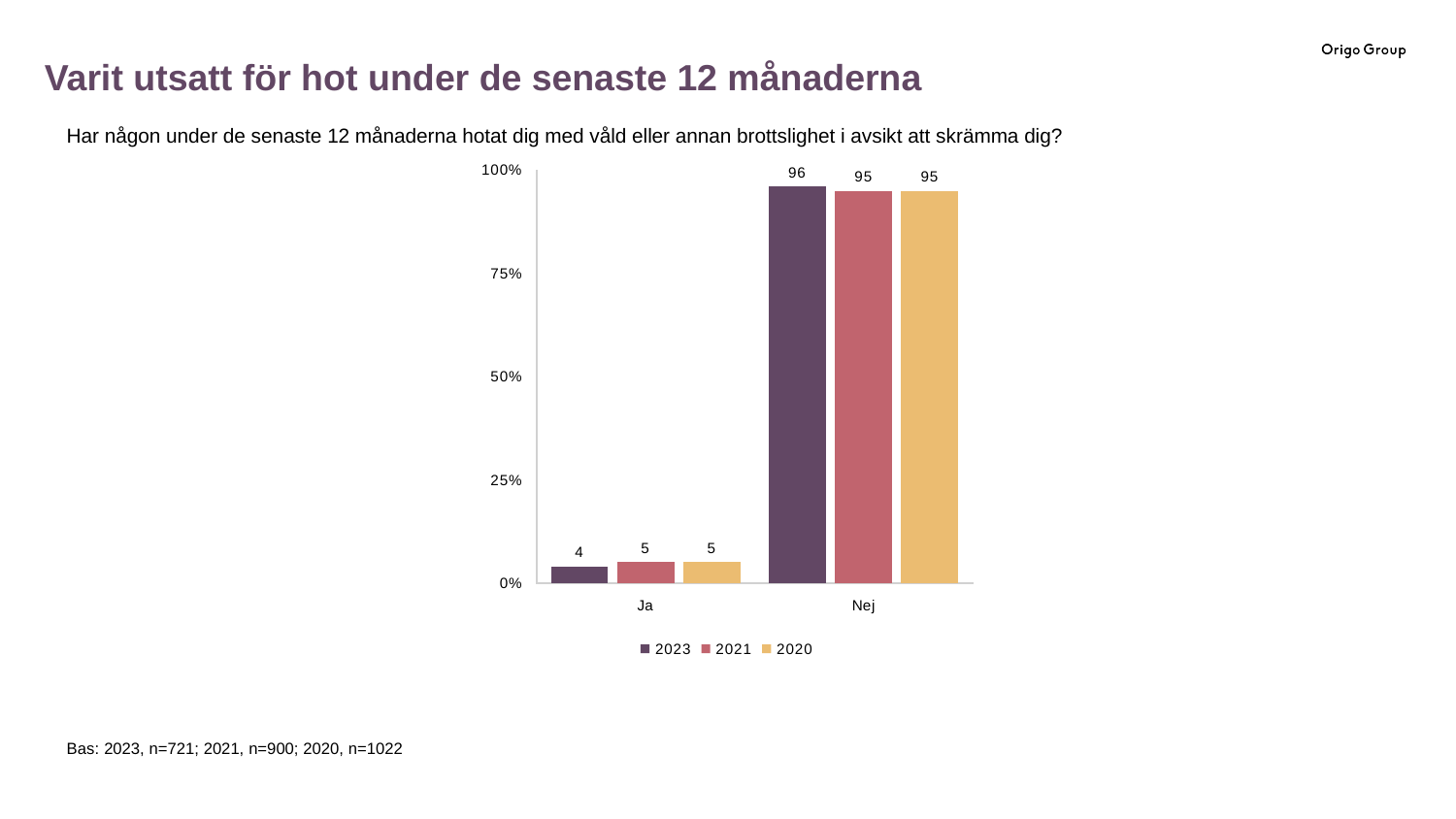
What is the difference between the 2023 and 2021 values in the Nej category? 1 What kind of chart is shown on the slide? Bar chart What is the value for 2021 in the Nej category? 95 Is the value for 2020 in the Nej category greater or less than 75%? greater How many series does the legend list? 3 Which category has the highest value for the 2023 series? Nej How many categories are shown on the x axis? 2 Which category has the lowest value for the 2021 series? Ja Which is larger: the 2023 value for Ja or the 2021 value for Ja? 2021 value for Ja What is the value for 2020 in the Ja category? 5 What is the value for 2023 in the Ja category? 4 What is the value for 2023 in the Nej category? 96